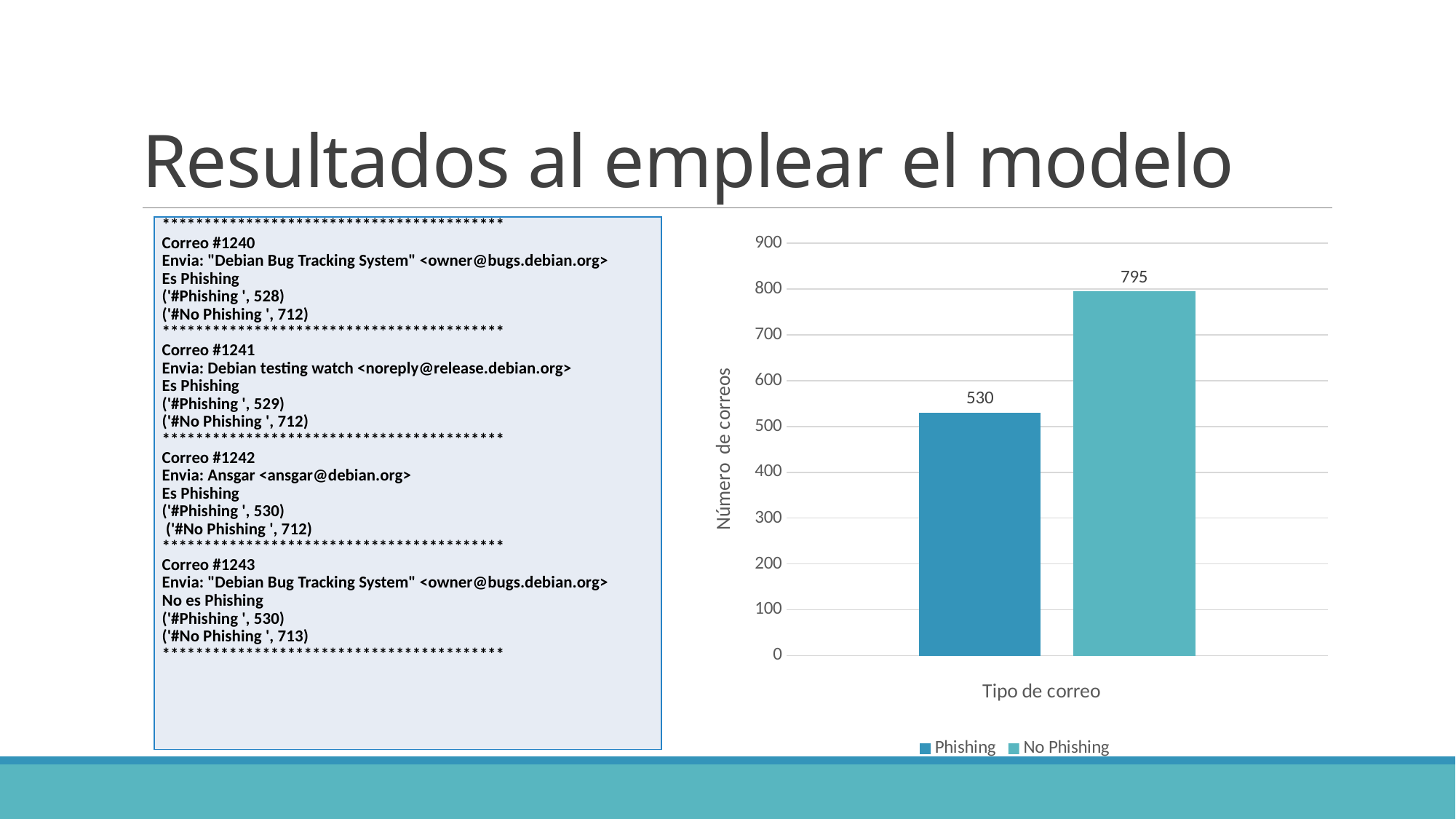
What is the value for Phishing in the chart? 530 Is the value for Phishing greater or less than 600? less Is the value for No Phishing greater or less than 700? greater What is the label of the vertical axis of the chart? Número de correos How many bars are plotted in the chart? 2 Which series has the highest value in the chart? No Phishing What is the difference between the No Phishing and Phishing values? 265 How many series does the legend list? 2 Which is larger, the value for Phishing or the value for No Phishing? No Phishing What is the value for No Phishing in the chart? 795 What kind of chart is shown on the slide? bar chart Which series has the lowest value in the chart? Phishing